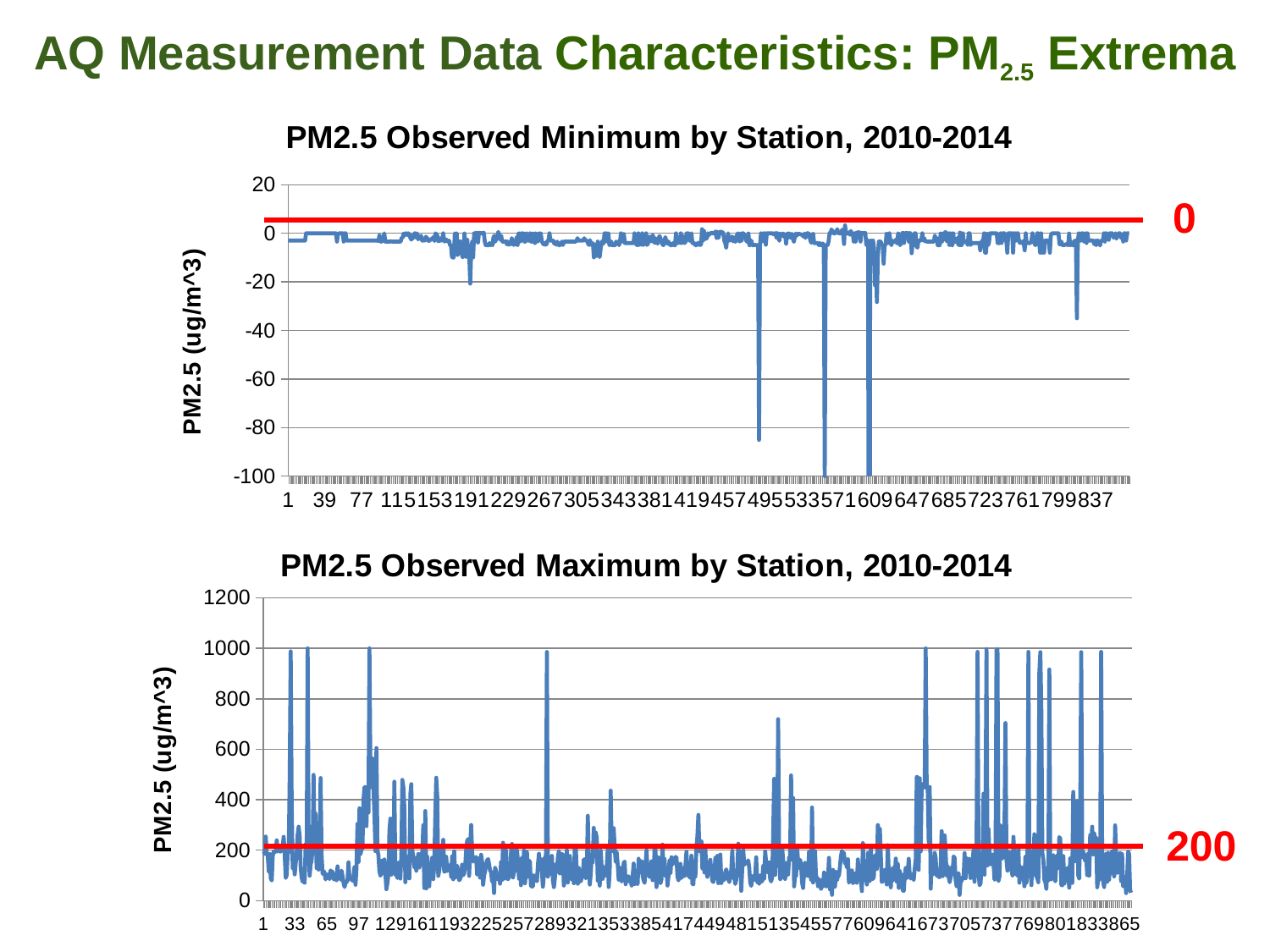
What is the title of the top chart on the slide? PM2.5 Observed Minimum by Station, 2010-2014 What kind of chart is the "PM2.5 Observed Minimum by Station, 2010-2014" chart? line chart How many charts are shown on the slide? 2 In the "PM2.5 Observed Minimum by Station, 2010-2014" chart, is the deepest dip in the line greater or less than -80? less In the "PM2.5 Observed Maximum by Station, 2010-2014" chart, what is the highest value shown on the y axis? 1200 In the "PM2.5 Observed Minimum by Station, 2010-2014" chart, what is the lowest value shown on the y axis? -100 In the "PM2.5 Observed Maximum by Station, 2010-2014" chart, are the tallest spikes in the line greater or less than 800? greater What is the y-axis label of the bottom chart, "PM2.5 Observed Maximum by Station, 2010-2014"? PM2.5 (ug/m^3) What kind of chart is the "PM2.5 Observed Maximum by Station, 2010-2014" chart? line chart In the "PM2.5 Observed Minimum by Station, 2010-2014" chart, what value is the red horizontal reference line labelled with? 0 In the "PM2.5 Observed Maximum by Station, 2010-2014" chart, is the value at station 1 greater or less than 600? less In the "PM2.5 Observed Maximum by Station, 2010-2014" chart, what value is the red horizontal reference line labelled with? 200